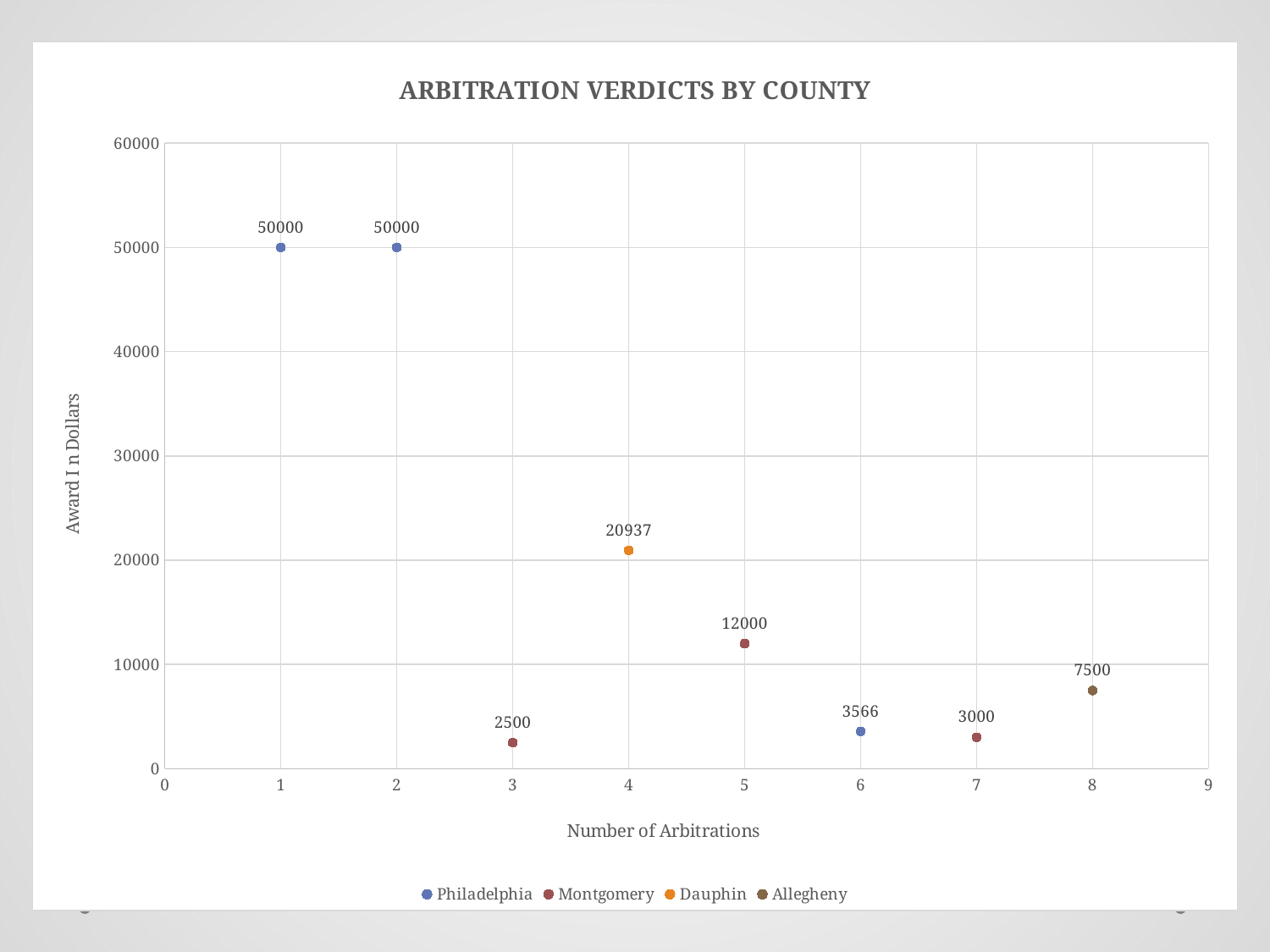
What is the award in dollars for arbitration number 6? 3566 What is the award in dollars for arbitration number 8 (Allegheny)? 7500 How many data points are plotted on the chart? 8 Which arbitration number has the lowest award? 3 What is the title of the chart? ARBITRATION VERDICTS BY COUNTY Is the award for arbitration number 1 greater or less than 40000? greater What is the difference between the award for arbitration 5 and the award for arbitration 7? 9000 How many series does the legend list? 4 Which is larger, the award for arbitration 4 or the award for arbitration 5? Arbitration 4 What type of chart is shown on the slide? Scatter chart What is the award in dollars for arbitration number 4 (Dauphin)? 20937 What is the label of the y axis? Award In Dollars